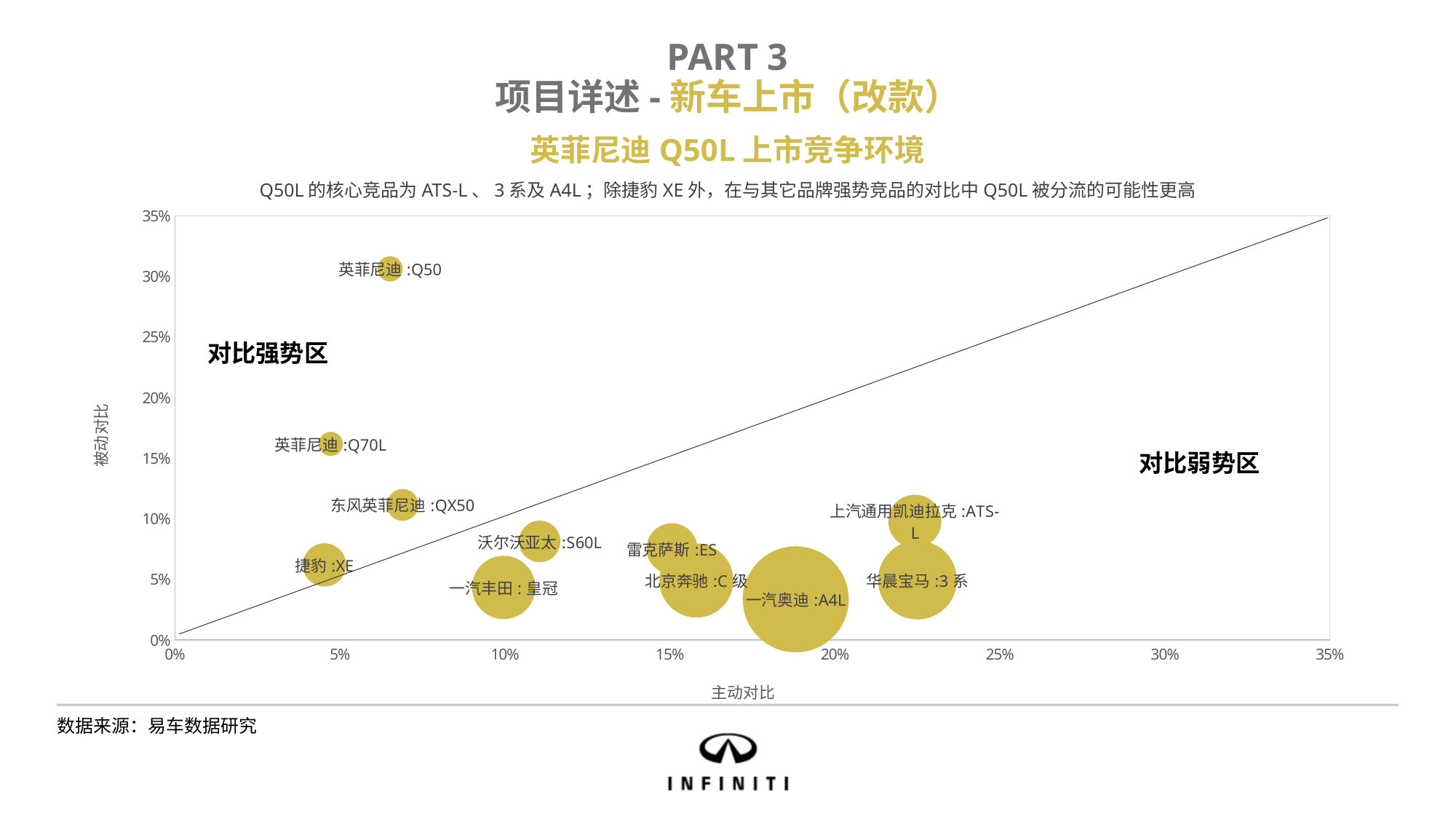
What is the label of the x axis of the chart? 主动对比 Which has a higher 被动对比 value, 东风英菲尼迪:QX50 or 一汽丰田:皇冠? 东风英菲尼迪:QX50 Is the 被动对比 value for 英菲尼迪:Q50 greater or less than 25%? greater Is the 主动对比 value for 华晨宝马:3系 greater or less than 20%? greater Is the 主动对比 value for 捷豹:XE greater or less than 10%? less What is the maximum value shown on the y axis of the chart? 35% Which has a higher 主动对比 value, 英菲尼迪:Q70L or 上汽通用凯迪拉克:ATS-L? 上汽通用凯迪拉克:ATS-L Which car model has the highest 被动对比 value on the chart? 英菲尼迪:Q50 What kind of chart is shown on the slide? bubble chart Which car model has the largest bubble on the chart? 一汽奥迪:A4L How many bubbles (car models) are plotted on the chart? 11